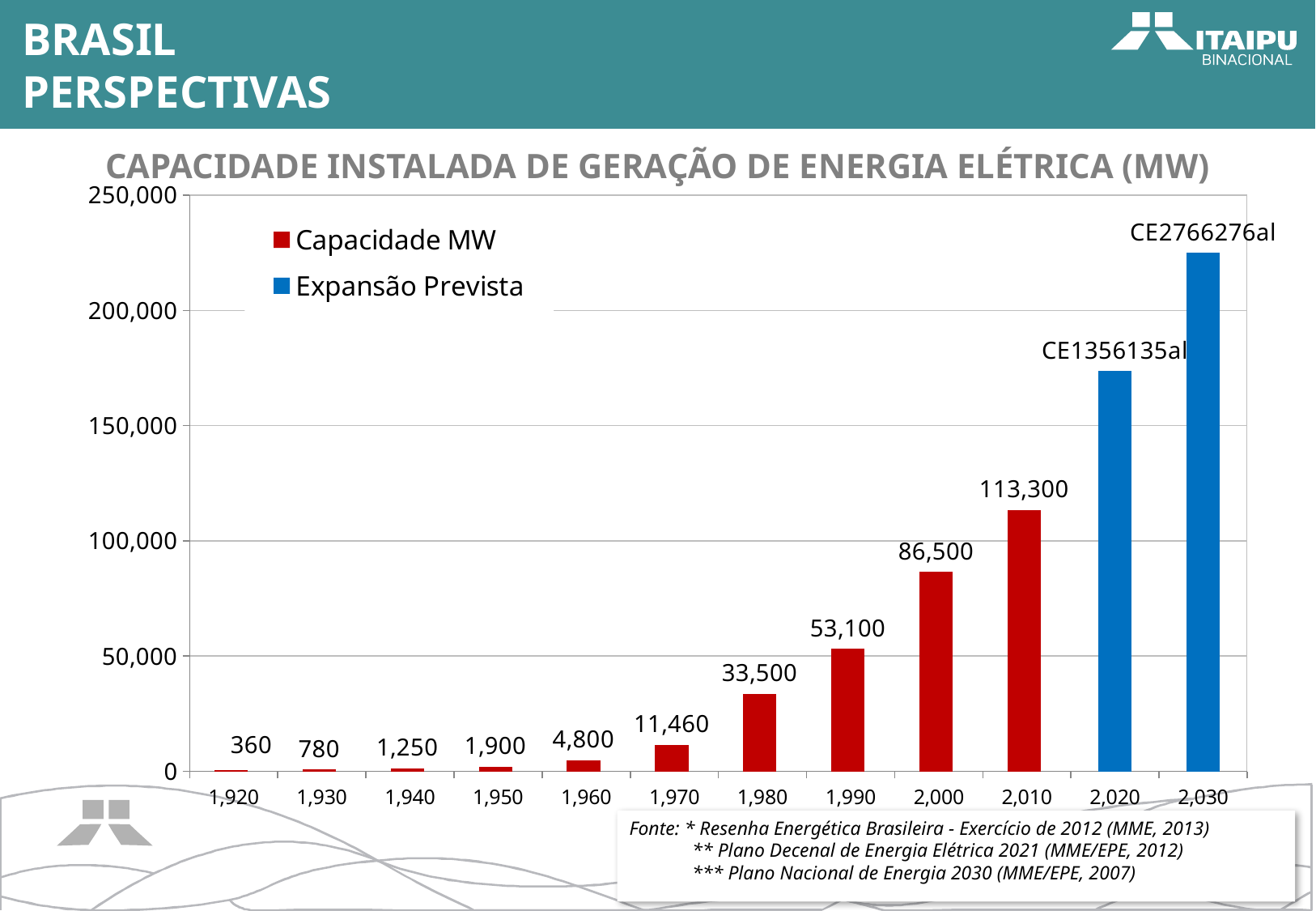
How many year categories are shown on the x axis? 12 Which is larger, the Capacidade MW value for 1,980 or for 1,990? 1,990 What is the Capacidade MW value for 1,920? 360 Which year has the lowest Capacidade MW value? 1,920 What is the difference between the Capacidade MW values for 2,010 and 2,000? 26,800 What is the Capacidade MW value for 1,970? 11,460 Is the Expansão Prevista value for 2,030 greater or less than 200,000? greater Do the Capacidade MW values rise or fall from 1,920 to 2,010? rise What type of chart is shown on the slide? bar chart What is the title of the chart? CAPACIDADE INSTALADA DE GERAÇÃO DE ENERGIA ELÉTRICA (MW) How many series does the legend list? 2 What is the Capacidade MW value for 2,010? 113,300